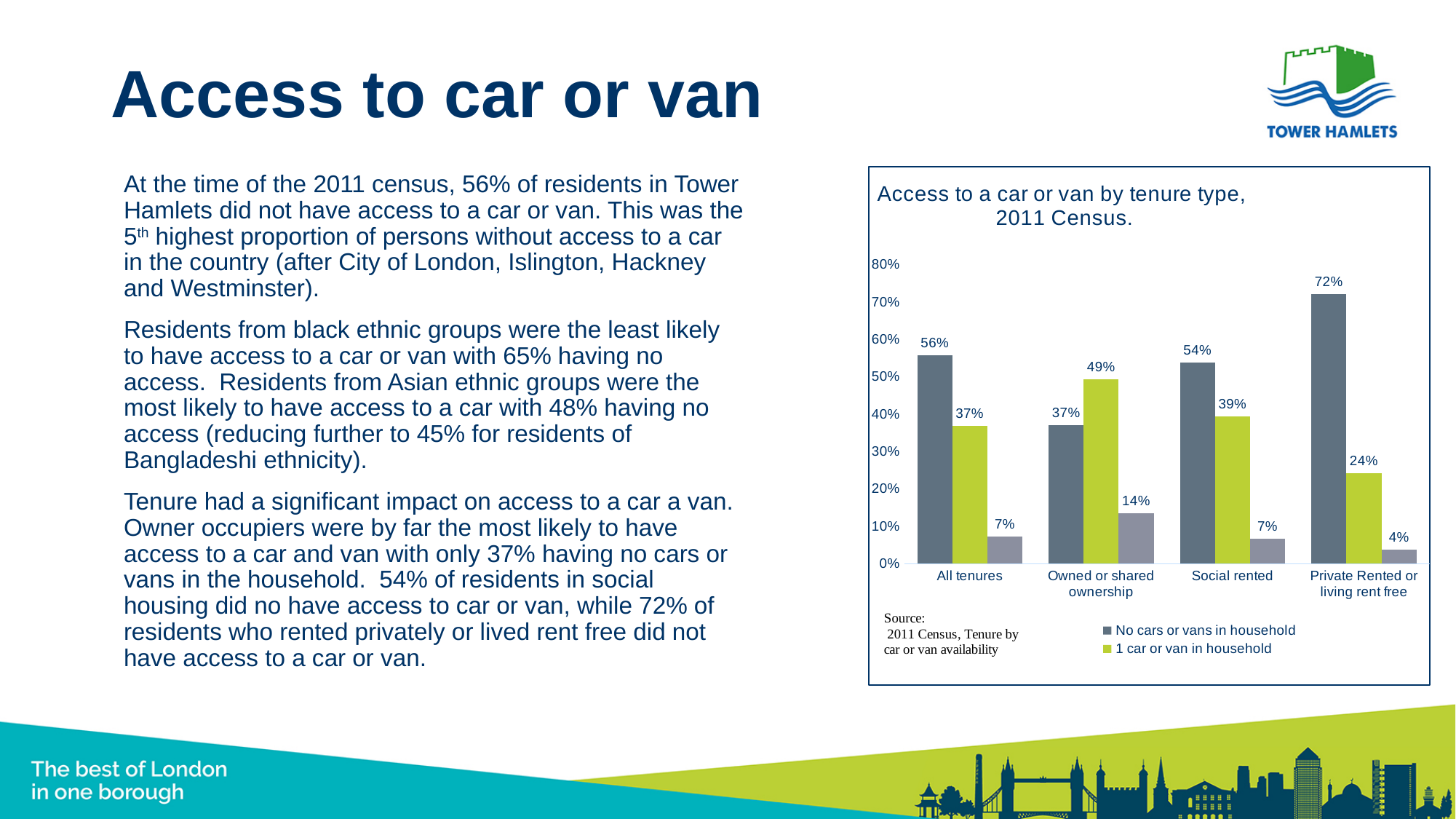
Is the '1 car or van in household' value for 'Private Rented or living rent free' greater or less than 30%? less How many tenure categories are shown on the x axis of the chart? 4 What is the difference between the 'No cars or vans in household' values for 'Social rented' and 'Owned or shared ownership'? 17 percentage points Which is larger for 'Social rented': the 'No cars or vans in household' value or the '1 car or van in household' value? No cars or vans in household What is the value for '1 car or van in household' in the 'Owned or shared ownership' category? 49% Which tenure category has the lowest proportion of households with no cars or vans? Owned or shared ownership What percentage of households in the 'Private Rented or living rent free' category have no cars or vans? 72% Which tenure category has the highest proportion of households with no cars or vans? Private Rented or living rent free What type of chart is shown on the slide? Bar chart What is the value for 'No cars or vans in household' for 'All tenures'? 56% What is the title of the chart? Access to a car or van by tenure type, 2011 Census. How many series does the chart's legend list? 2